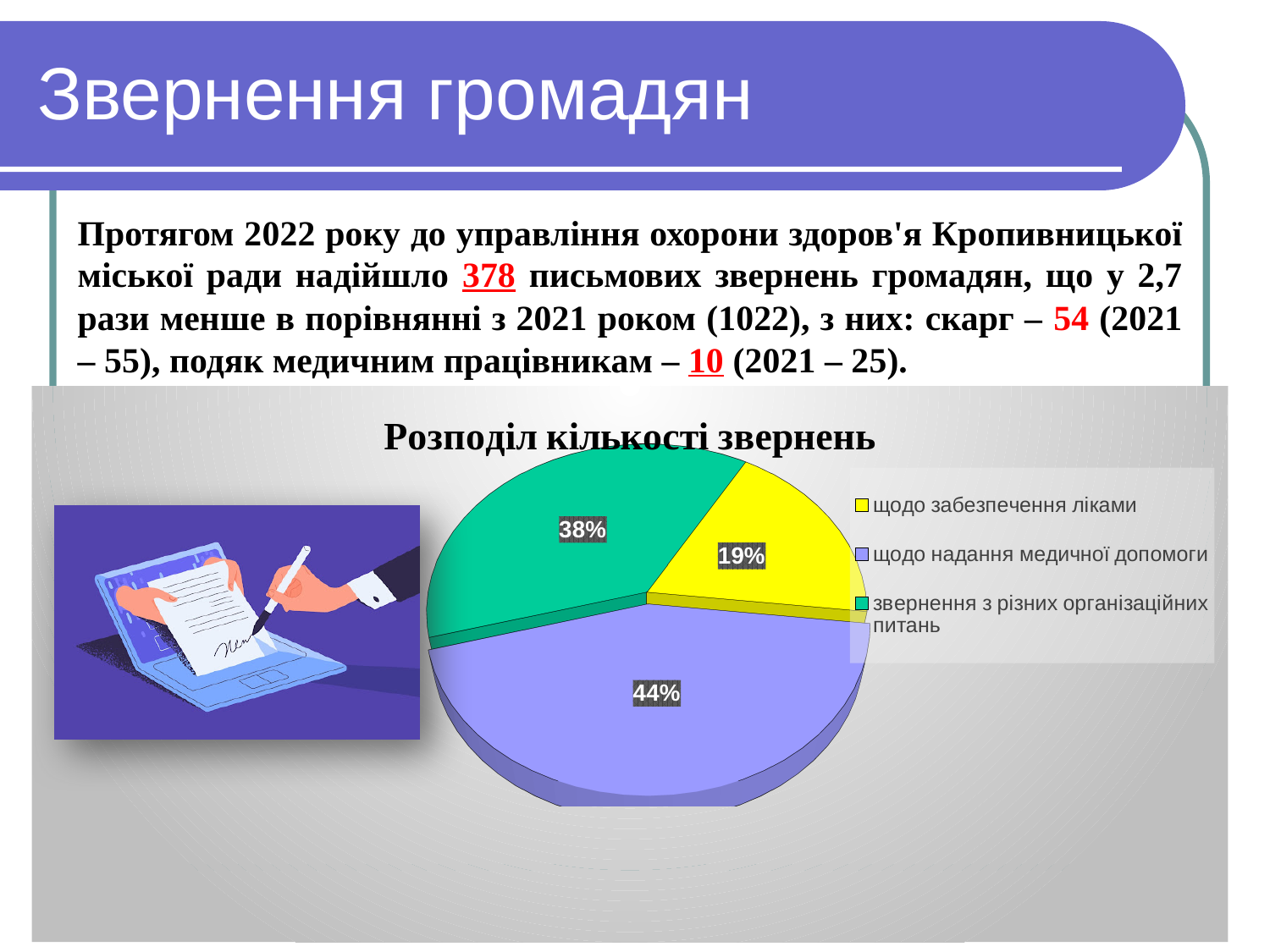
Which category has the largest slice of the pie? щодо надання медичної допомоги How many slices does the pie chart have? 3 What share of the pie does "щодо надання медичної допомоги" take? 44% How many entries does the legend list? 3 Which is larger: the share for "звернення з різних організаційних питань" or the share for "щодо забезпечення ліками"? звернення з різних організаційних питань Which category has the smallest slice of the pie? щодо забезпечення ліками What share of the pie does "щодо забезпечення ліками" take? 19% What colour is the slice for "щодо забезпечення ліками"? yellow What is the title of the chart? Розподіл кількості звернень What share of the pie does "звернення з різних організаційних питань" take? 38% What kind of chart is shown on the slide? pie chart What is the difference in percentage points between "щодо надання медичної допомоги" and "щодо забезпечення ліками"? 25